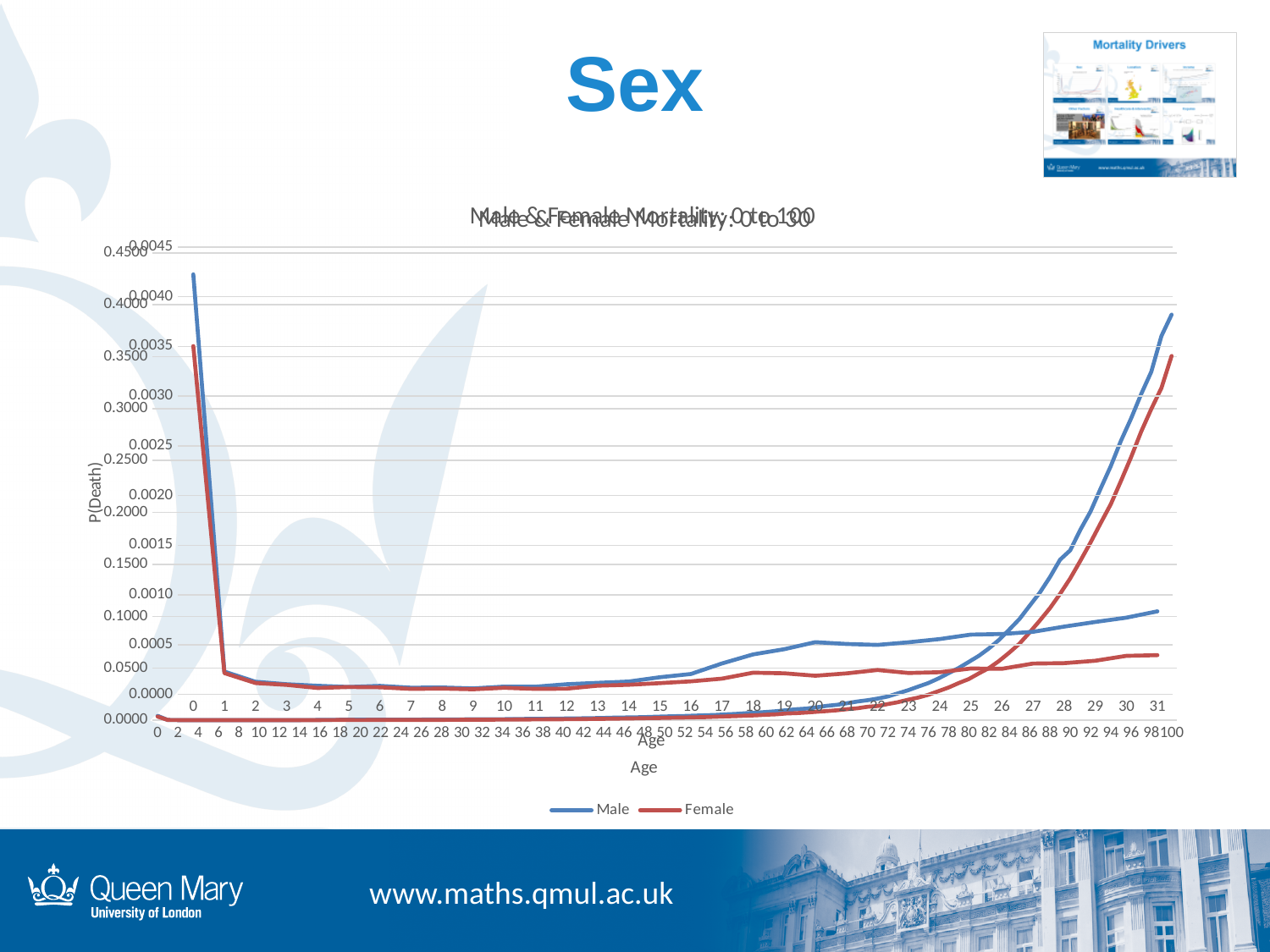
In the Male & Female Mortality: 0 to 30 chart, is the Male value at age 0 greater or less than 0.0040? greater In the Male & Female Mortality: 0 to 100 chart, which series is higher at age 100, Male or Female? Male In the Male & Female Mortality: 0 to 100 chart, is the Female value at age 100 greater or less than 0.3000? greater In the Male & Female Mortality: 0 to 100 chart, is the Male value at age 100 greater or less than 0.3500? greater In the Male & Female Mortality: 0 to 30 chart, which series is higher at age 0, Male or Female? Male What kind of chart is shown on the slide? line chart In the Male & Female Mortality: 0 to 100 chart, do the Male and Female values rise or fall between age 60 and age 100? rise What is the label on the y axis? P(Death) What colour is the Male series line? blue In the Male & Female Mortality: 0 to 30 chart, do the values rise or fall between age 0 and age 1? fall Which two series are listed in the legend? Male and Female How many series does the legend list? 2